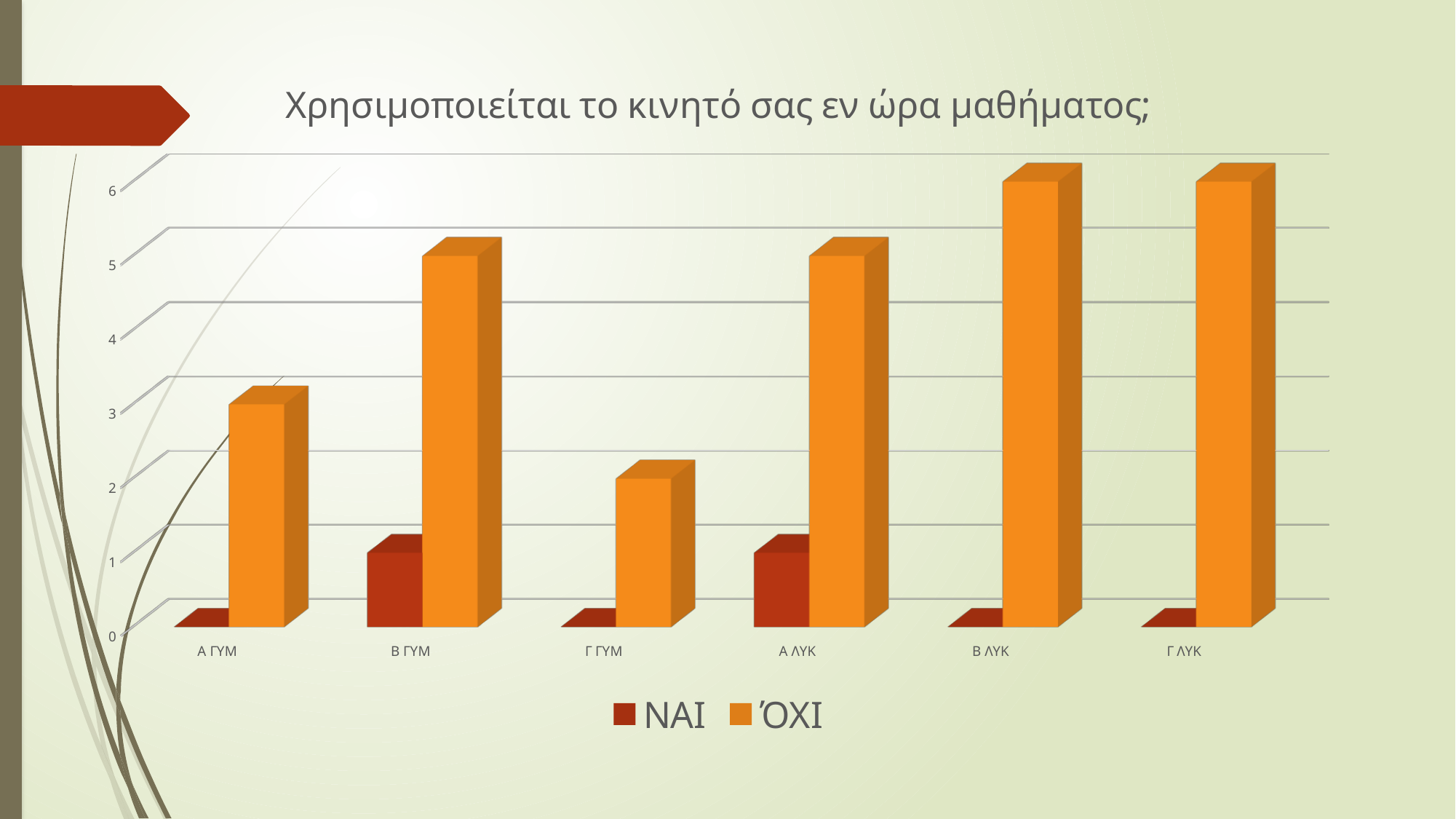
Is the value of ΌΧΙ for Α ΛΥΚ greater or less than 4? greater Which category has the lowest value for ΌΧΙ? Γ ΓΥΜ What is the difference between the ΌΧΙ values for Β ΓΥΜ and Γ ΓΥΜ? 3 What is the value of ΌΧΙ for Β ΛΥΚ? 6 How many series does the legend list? 2 What kind of chart is shown on the slide? bar chart What is the value of ΝΑΙ for Β ΓΥΜ? 1 Which is larger, the ΌΧΙ value for Β ΓΥΜ or for Α ΓΥΜ? Β ΓΥΜ What is the value of ΌΧΙ for Γ ΓΥΜ? 2 How many categories are shown on the x axis? 6 What is the value of ΌΧΙ for Α ΓΥΜ? 3 What is the title of the chart? Χρησιμοποιείται το κινητό σας εν ώρα μαθήματος;